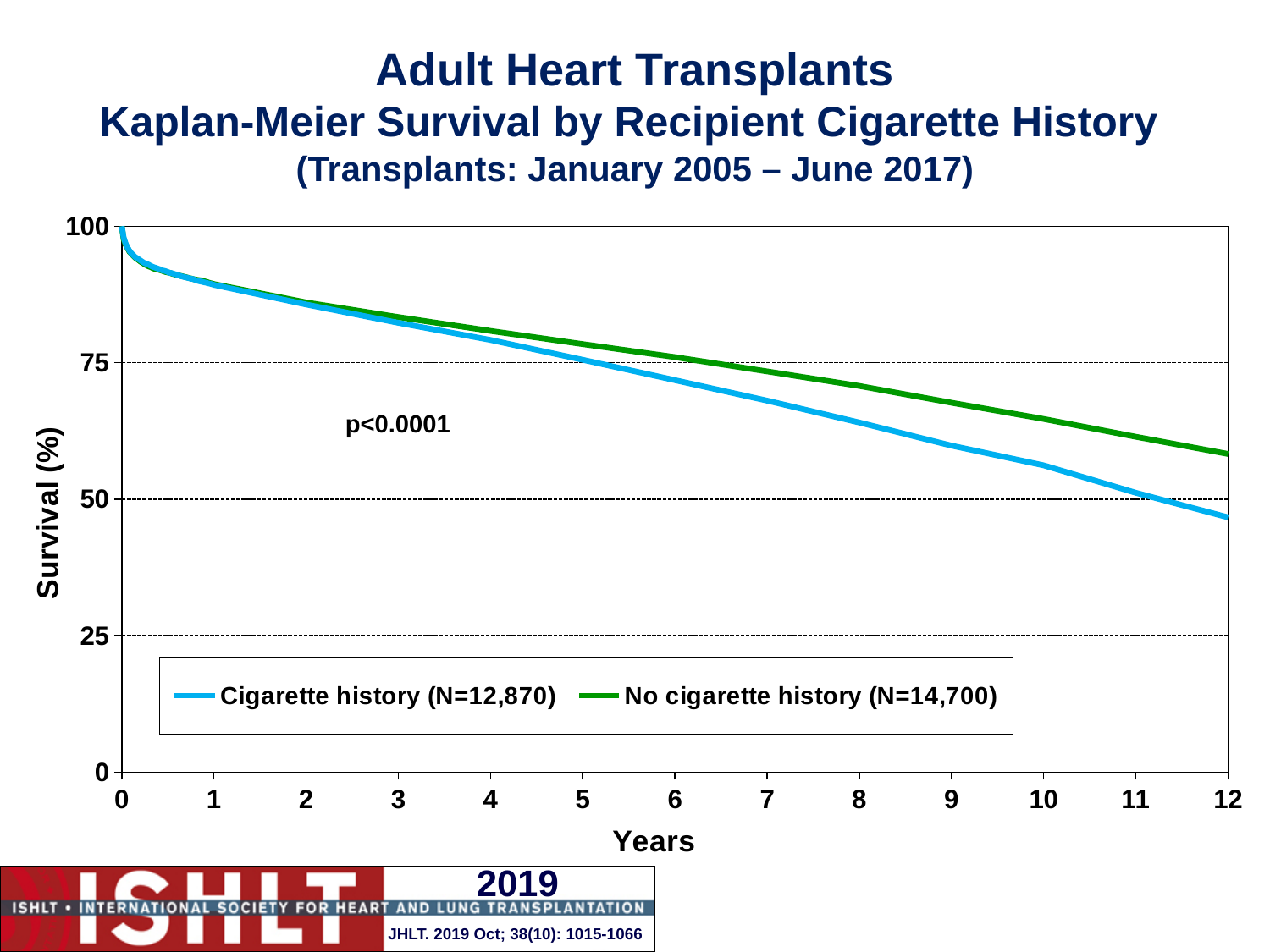
Is the survival for Cigarette history at 8 years greater or less than 75? less Is the survival for No cigarette history at 12 years greater or less than 50? greater What kind of chart is shown on the slide? line chart Is the survival for Cigarette history at 12 years greater or less than 50? less What p-value is printed on the chart? p<0.0001 What is the N for the Cigarette history group shown in the legend? 12,870 How many series does the legend list? 2 Which series has the higher survival at 12 years? No cigarette history Do the survival curves rise or fall as years increase? fall Which series has the lower survival at 12 years? Cigarette history